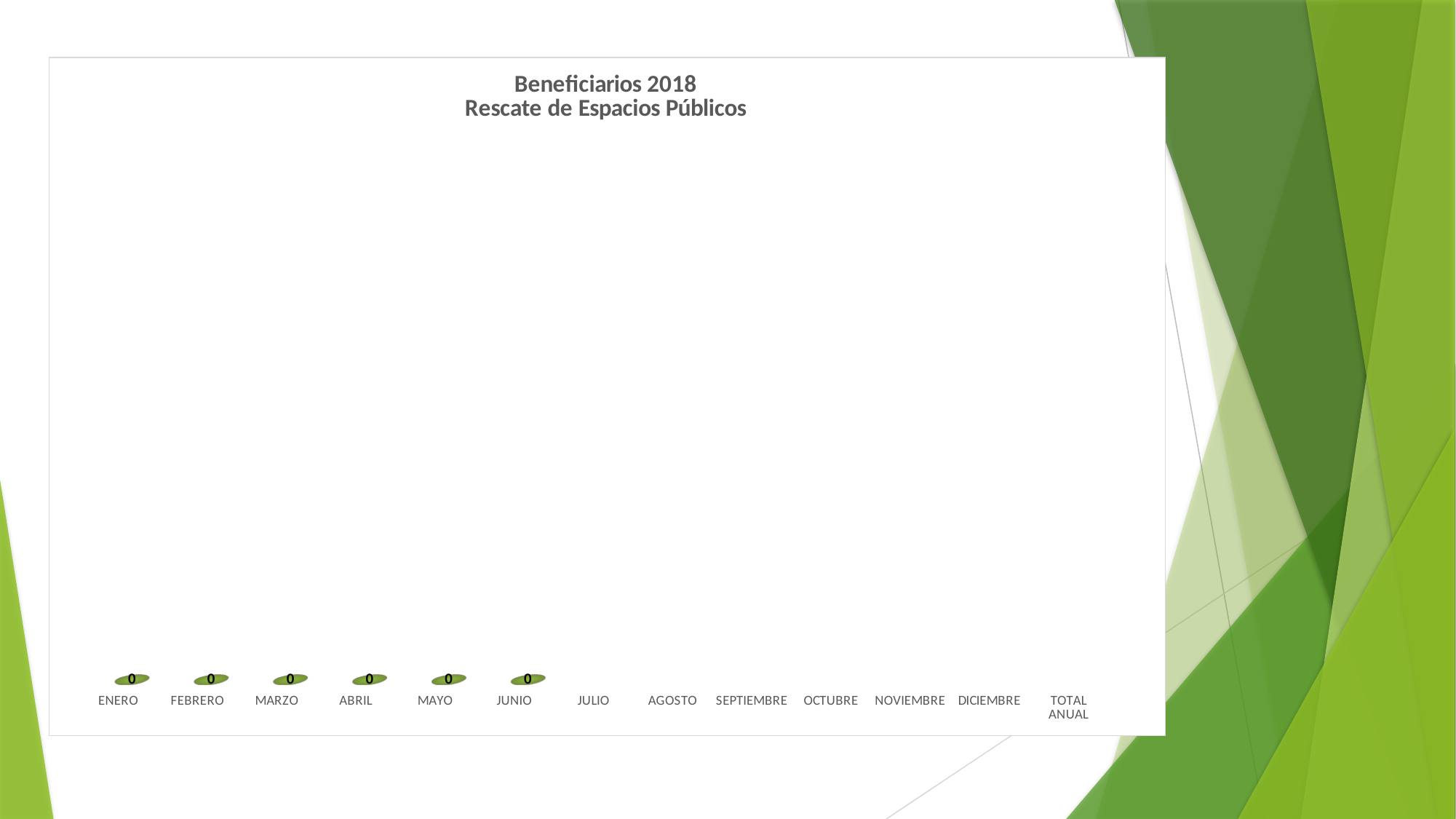
What kind of chart is this? bar chart How many categories are shown on the x axis? 13 What is the value for JUNIO? 0 What is the value for MAYO? 0 What is the value for ABRIL? 0 What is the title of the chart? Beneficiarios 2018 Rescate de Espacios Públicos What is the difference between the values for ENERO and JUNIO? 0 How many categories have a data label printed on the chart? 6 What is the value for MARZO? 0 What is the label of the last category on the x axis? TOTAL ANUAL What is the value for ENERO? 0 What is the value for FEBRERO? 0